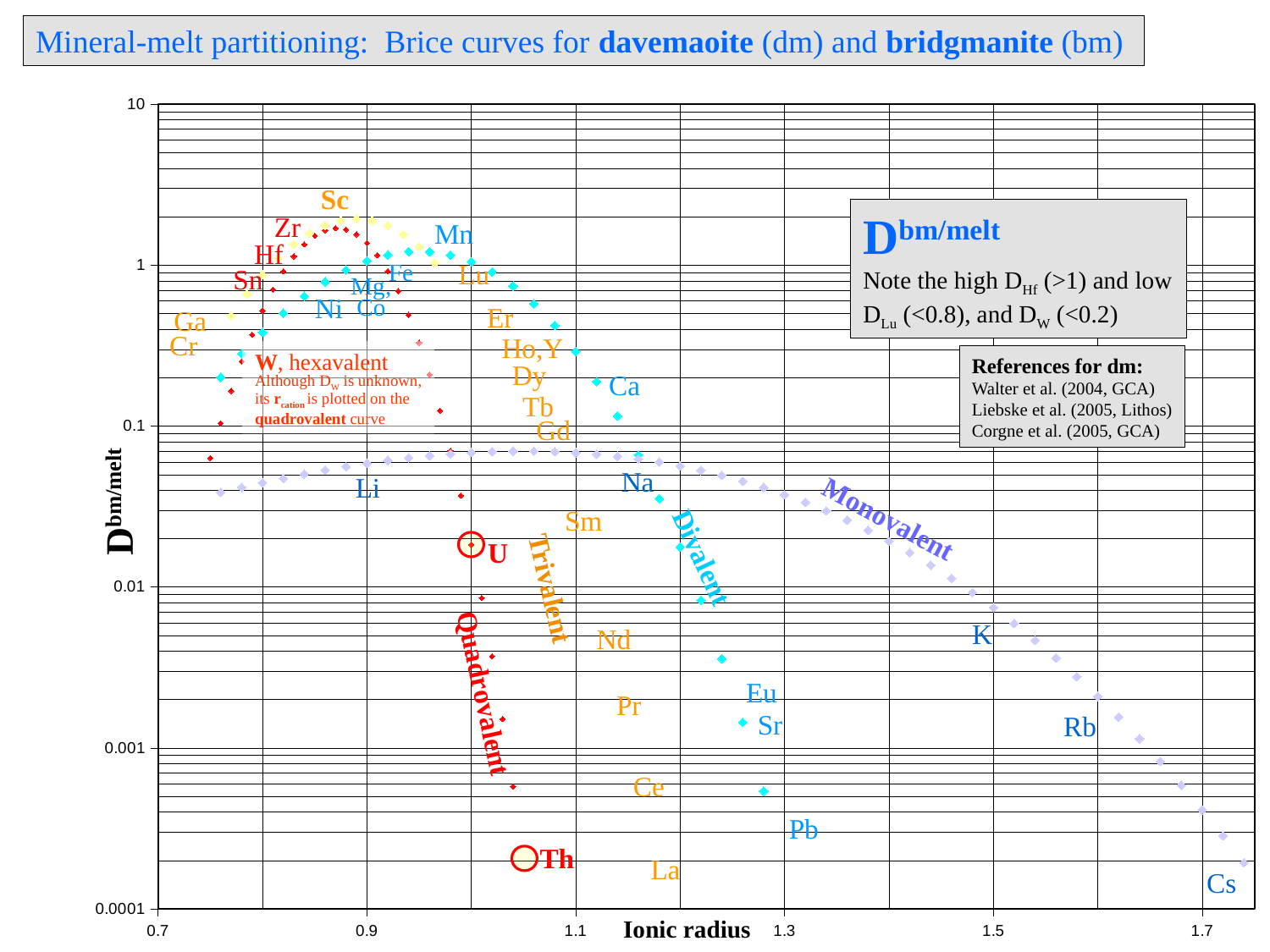
Which has the larger value, Hf or Cs? Hf Is the value for Sc greater or less than 1? greater Is the value for U greater or less than 0.01? greater Is the value for K greater or less than 0.01? less What is the label of the x axis? Ionic radius What kind of chart is shown on the slide? scatter chart What is the label of the y axis? D bm/melt Along the monovalent curve, do the values rise or fall as ionic radius increases from Na to Cs? fall